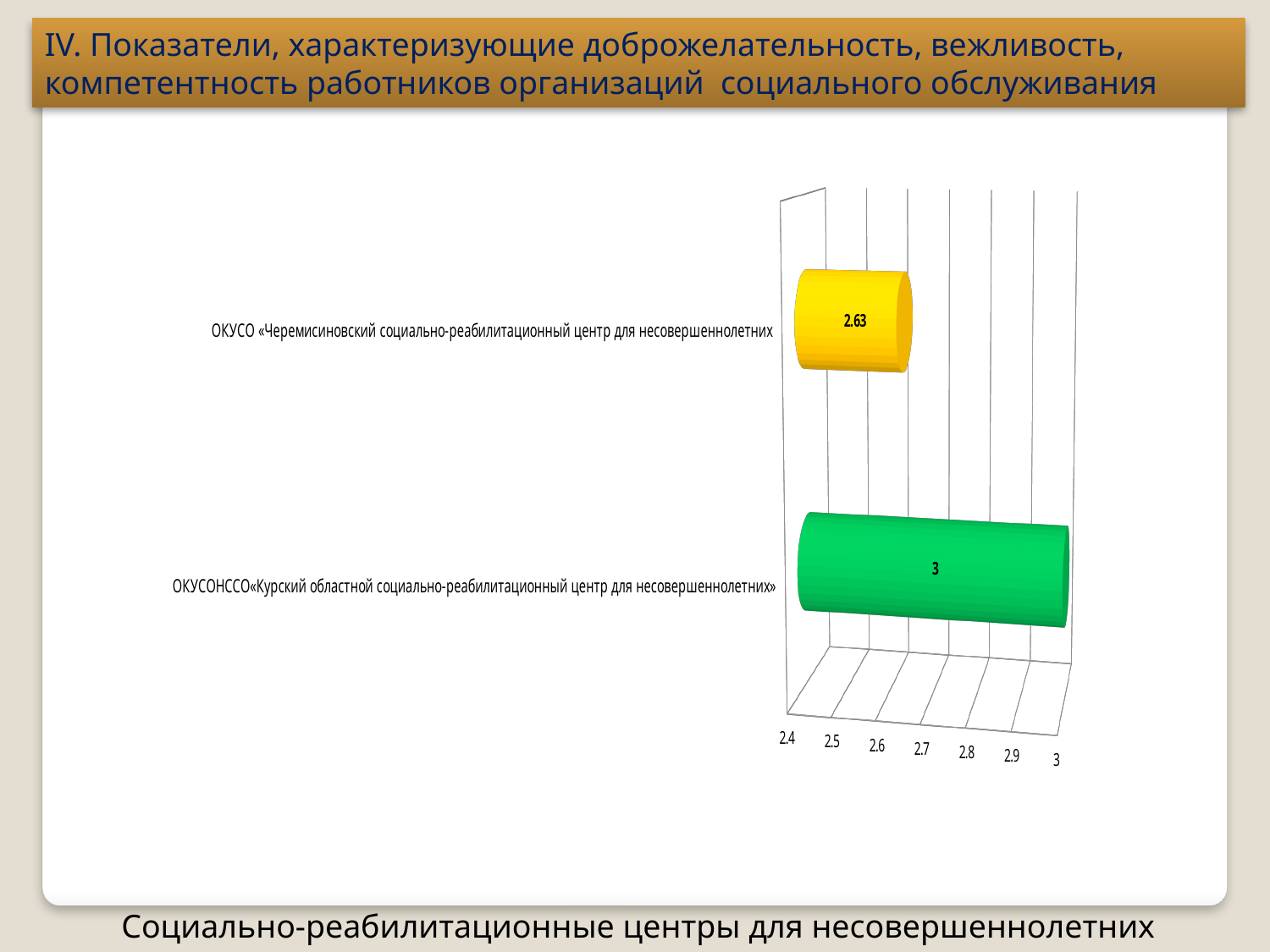
What colour is the bar for the Курский областной центр? green Is the value for the Черемисиновский центр greater or less than 2.8? less Which category has the lowest value? ОКУСО «Черемисиновский социально-реабилитационный центр для несовершеннолетних» What is the lowest value shown on the value axis? 2.4 Which is larger: the value for the Черемисиновский центр or the value for the Курский областной центр? Курский областной центр What is the value for ОКУСОНССО «Курский областной социально-реабилитационный центр для несовершеннолетних»? 3 Is the value for the Курский областной центр greater or less than 2.9? greater Which category has the highest value? ОКУСОНССО «Курский областной социально-реабилитационный центр для несовершеннолетних» How many categories are shown in the chart? 2 What is the value for ОКУСО «Черемисиновский социально-реабилитационный центр для несовершеннолетних»? 2.63 What kind of chart is shown on the slide? bar chart What is the difference between the value for the Курский областной центр and the value for the Черемисиновский центр? 0.37